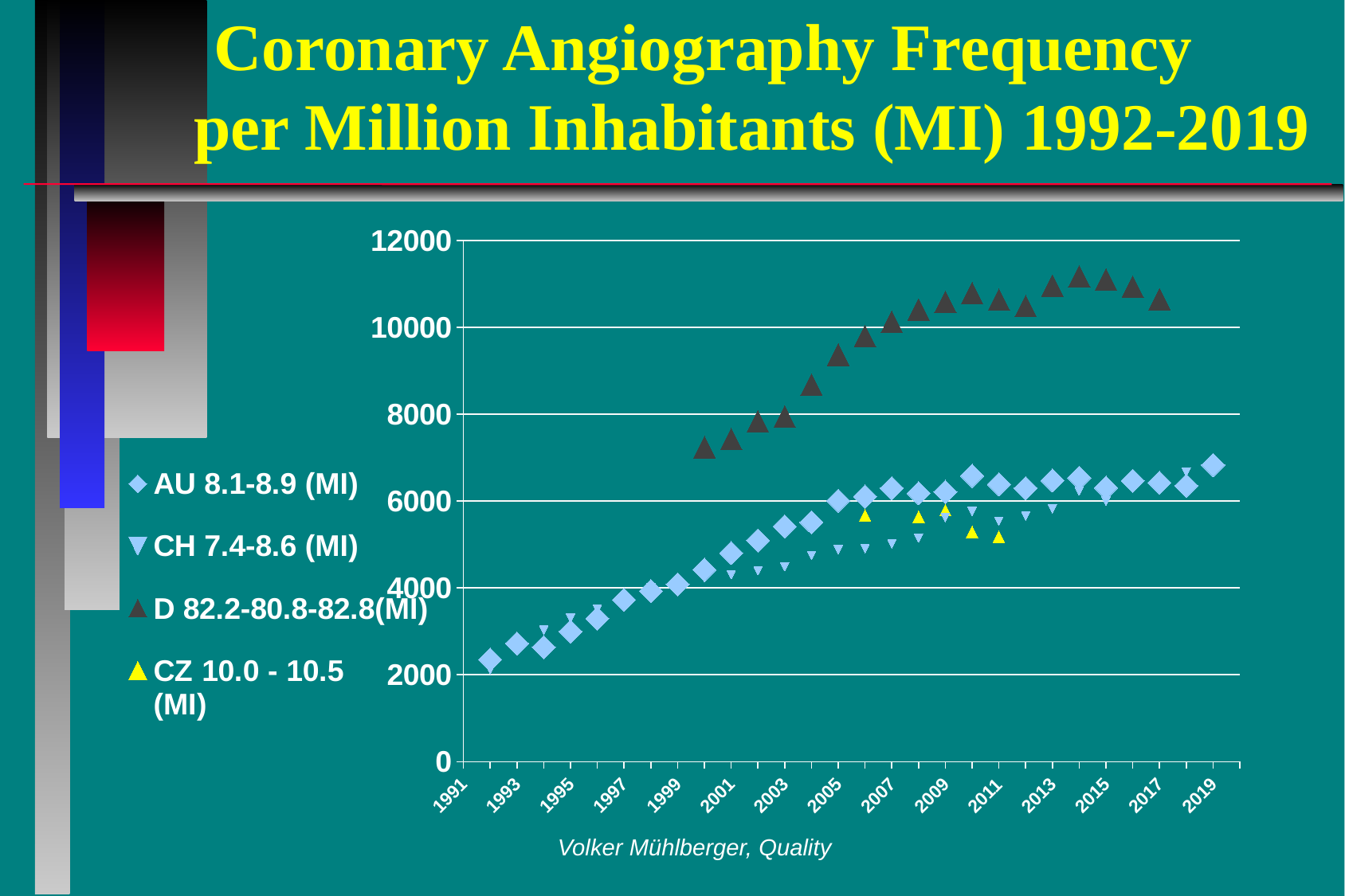
How many series does the legend list? 4 Which is larger in 2010, the value for D or the value for AU? D Is the value for D in 2015 greater or less than 10000? greater What kind of chart is shown on the slide? scatter chart Is the value for CH in 2005 greater or less than 6000? less Which series is represented by the yellow triangle markers? CZ 10.0 - 10.5 (MI) Is the value for AU in 1992 greater or less than 4000? less What is the title of the chart on the slide? Coronary Angiography Frequency per Million Inhabitants (MI) 1992-2019 Do the AU values rise or fall from 1992 to 2019? rise Which series has the highest values on the chart? D 82.2-80.8-82.8(MI)